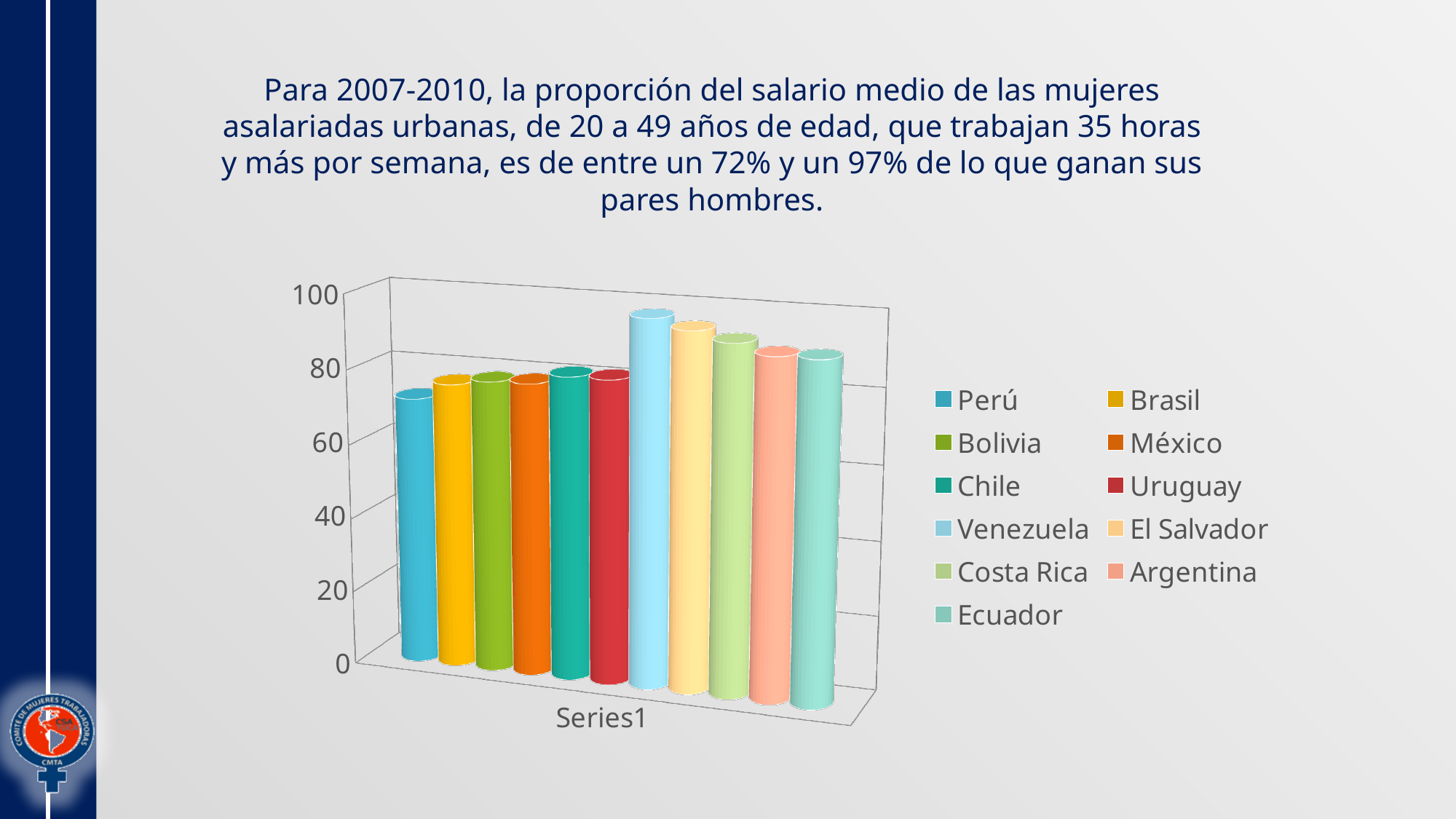
What is the highest value shown on the vertical axis? 100 What label appears on the horizontal axis below the bars? Series1 Is the value for Bolivia greater or less than 60? greater Which is larger, the value for Costa Rica or the value for Bolivia? Costa Rica Which country has the highest bar in the chart? Venezuela Which country has the lowest bar in the chart? Perú What kind of chart is shown on the slide? bar chart How many series does the chart legend list? 11 Which is larger, the value for El Salvador or the value for México? El Salvador Is the value for Argentina greater or less than 80? greater Is the value for Perú greater or less than 80? less